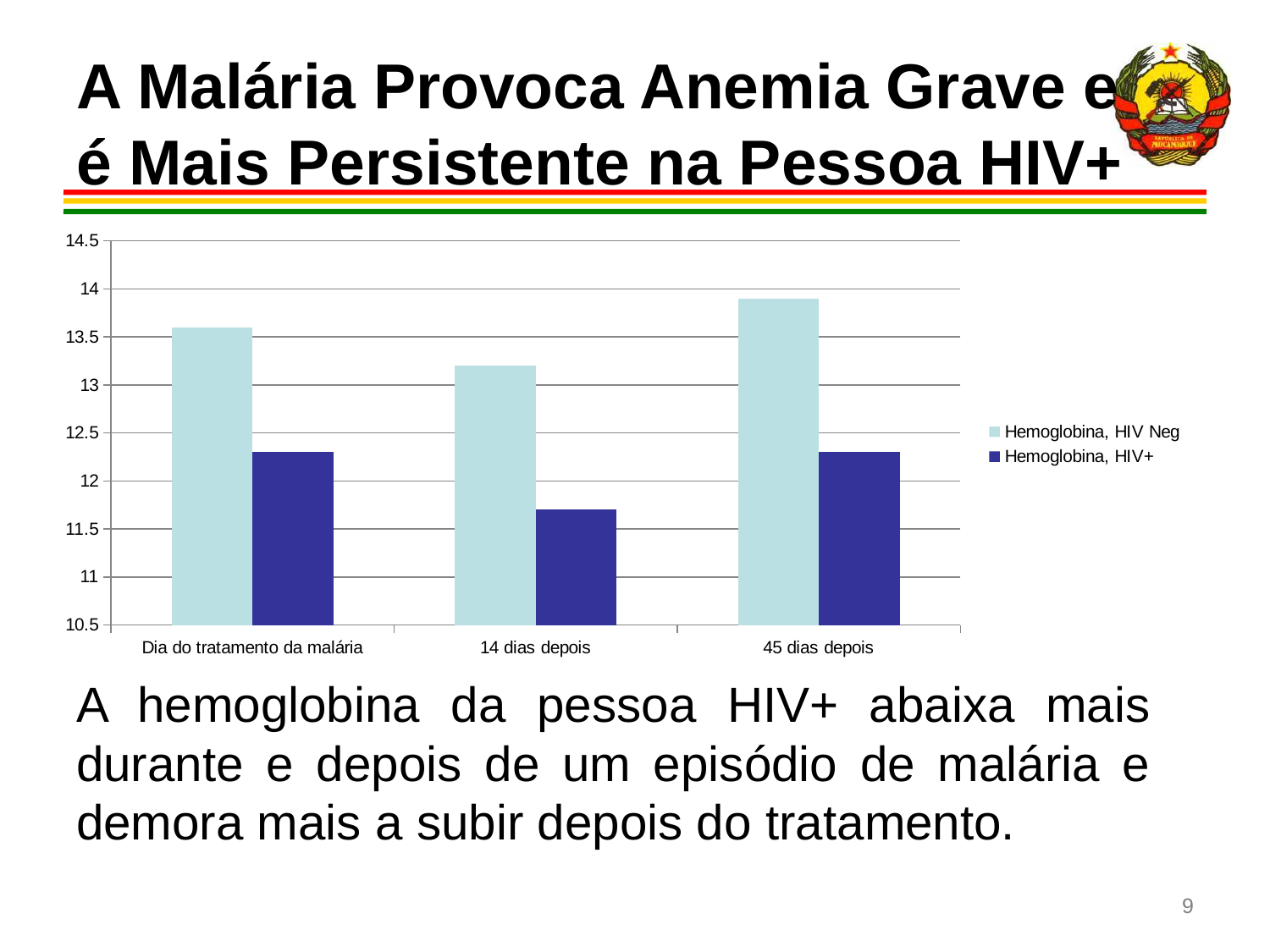
What are the two legend entries of the chart? Hemoglobina, HIV Neg; Hemoglobina, HIV+ For which category is Hemoglobina, HIV Neg highest? 45 dias depois Is the value for Hemoglobina, HIV Neg at 45 dias depois greater or less than 13.5? greater Does Hemoglobina, HIV+ rise or fall from Dia do tratamento da malária to 14 dias depois? fall Is the value for Hemoglobina, HIV+ at Dia do tratamento da malária greater or less than 12.5? less How many series does the legend list? 2 At 14 dias depois, which is larger: Hemoglobina, HIV Neg or Hemoglobina, HIV+? Hemoglobina, HIV Neg Is the value for Hemoglobina, HIV+ at 14 dias depois greater or less than 12? less How many categories are shown on the x axis? 3 For which category is Hemoglobina, HIV+ lowest? 14 dias depois What kind of chart is shown on the slide? bar chart